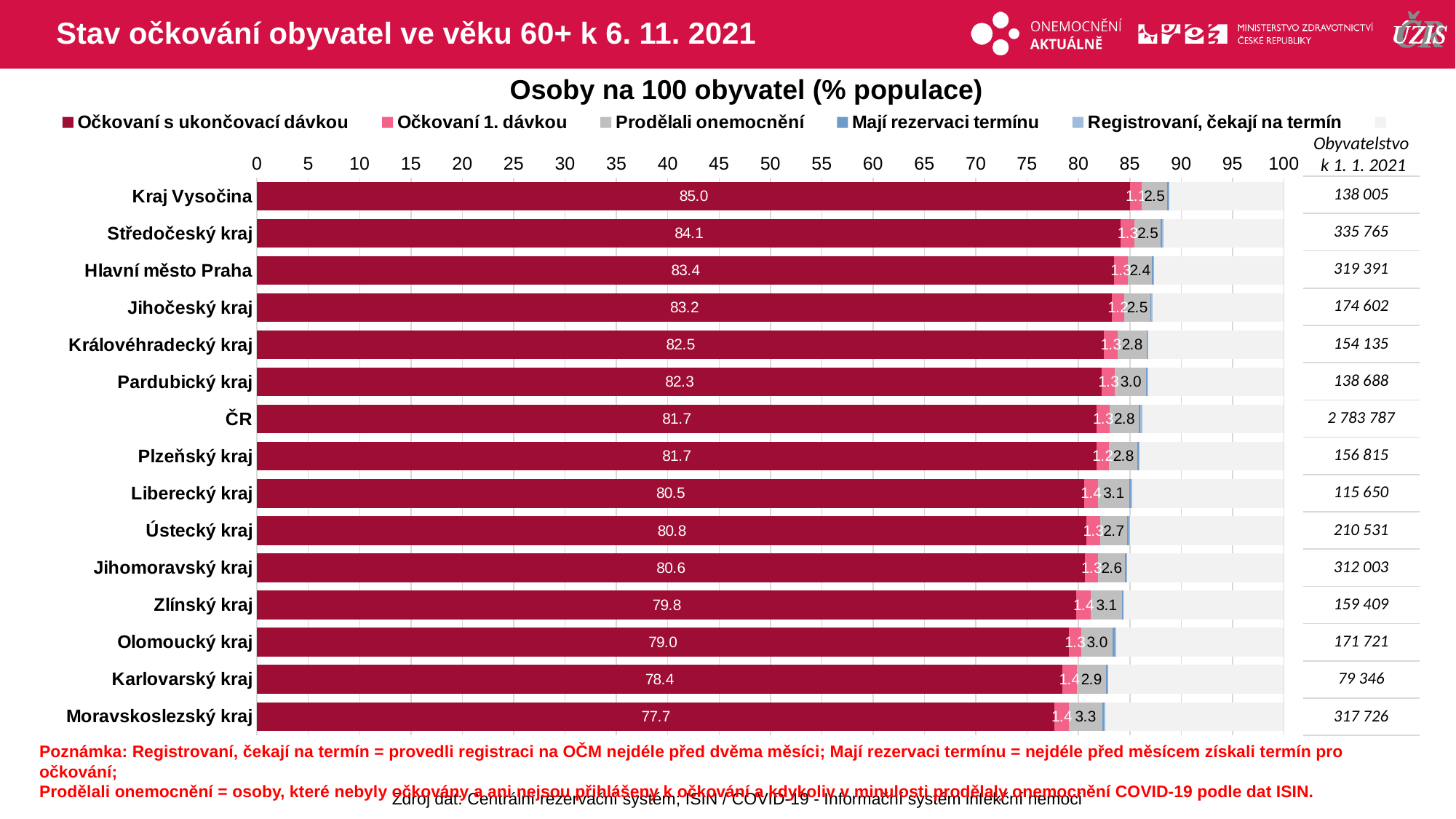
Which category has the highest value of 'Očkovaní s ukončovací dávkou'? Kraj Vysočina Is the value of 'Očkovaní s ukončovací dávkou' for Karlovarský kraj greater or less than 80? less Which category has the lowest value of 'Očkovaní s ukončovací dávkou'? Moravskoslezský kraj How many categories (rows) are shown on the chart? 15 What is the value of 'Očkovaní s ukončovací dávkou' for ČR? 81.7 What type of chart is shown on the slide? stacked bar chart Which has a larger value of 'Očkovaní s ukončovací dávkou': Středočeský kraj or Olomoucký kraj? Středočeský kraj What is the title of the chart? Osoby na 100 obyvatel (% populace) What is the value of 'Prodělali onemocnění' for Moravskoslezský kraj? 3.3 What is the value of 'Očkovaní s ukončovací dávkou' for Moravskoslezský kraj? 77.7 What is the difference in 'Očkovaní s ukončovací dávkou' between Kraj Vysočina and Moravskoslezský kraj? 7.3 What is the value of 'Očkovaní s ukončovací dávkou' for Kraj Vysočina? 85.0